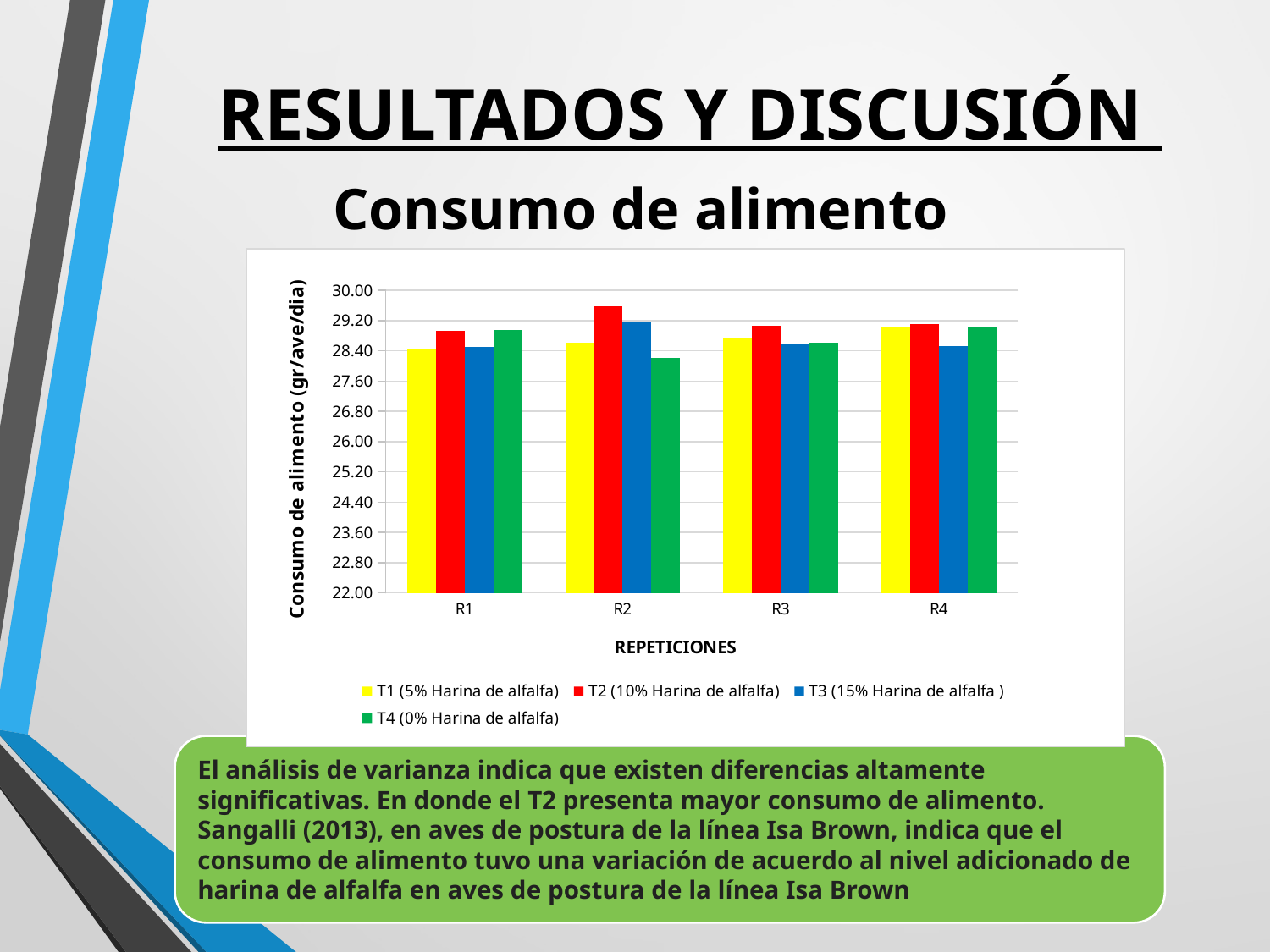
Is the value for T2 (10% Harina de alfalfa) at R2 greater or less than 29.20? greater What kind of chart is shown on the slide? bar chart Which series has the lowest bar in the R2 group? T4 (0% Harina de alfalfa) How many repetition categories are shown on the x axis? 4 What is the title of the y axis? Consumo de alimento (gr/ave/dia) Which repetition group contains the tallest bar in the whole chart? R2 Which is larger: the T2 (10% Harina de alfalfa) bar at R2 or the T2 bar at R1? R2 How many series does the legend list? 4 Is the value for T4 (0% Harina de alfalfa) at R2 greater or less than 28.40? less Which series has the highest bar in the R2 group? T2 (10% Harina de alfalfa) What colour are the bars for T2 (10% Harina de alfalfa)? red Is the value for T2 (10% Harina de alfalfa) at R1 greater or less than 28.40? greater